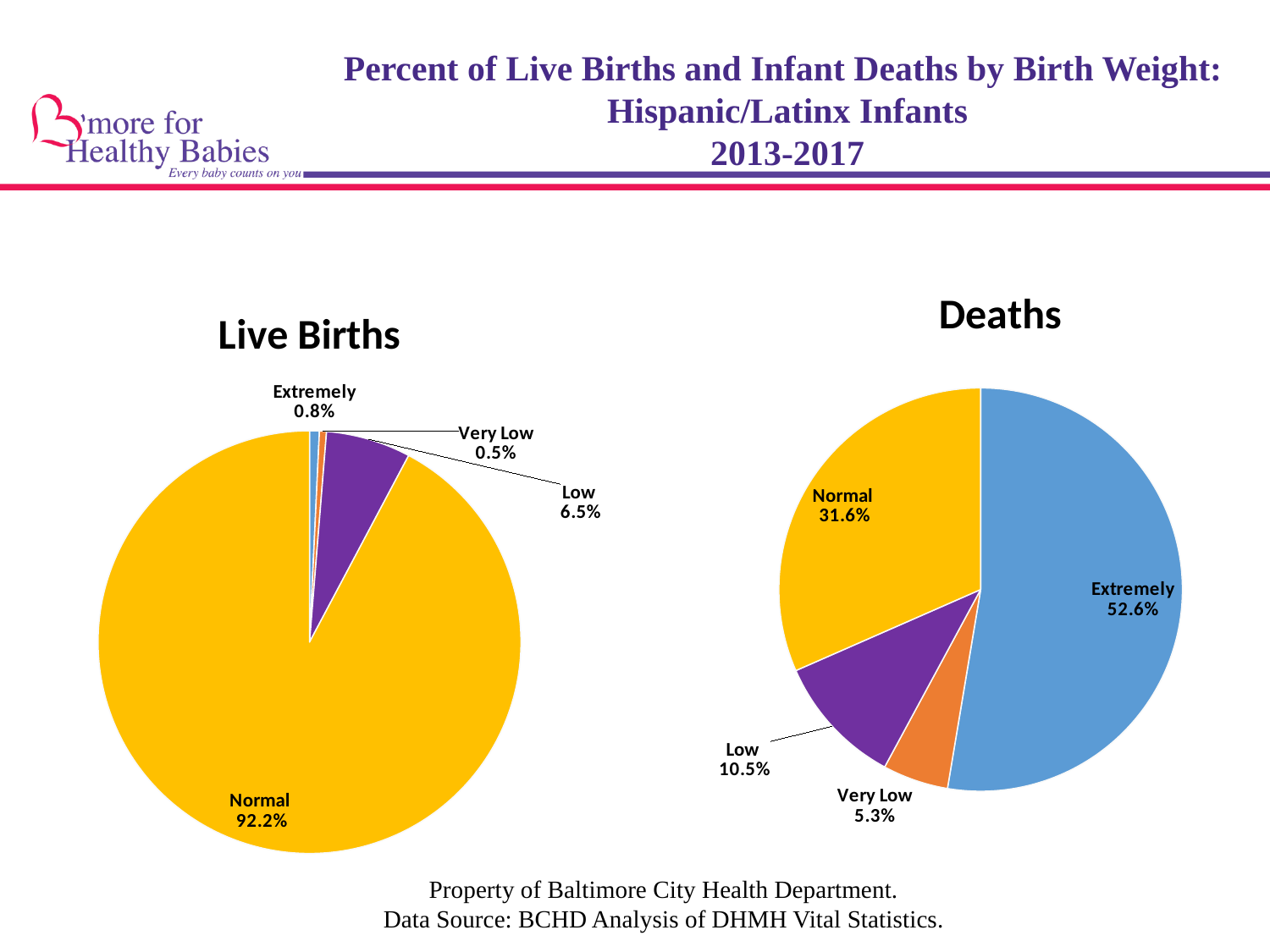
In the Deaths chart, what is the difference between the Extremely and Normal shares? 21.0% In the Deaths chart, what percentage of infant deaths were Extremely low birth weight? 52.6% How many birth weight categories are shown in the Deaths chart? 4 In the Deaths chart, which category has the smallest share? Very Low In the Deaths chart, what is the value for Very Low birth weight? 5.3% In the Deaths chart, which birth weight category has the largest share? Extremely In the Live Births chart, which birth weight category has the smallest share? Very Low In the Live Births chart, what is the difference between the Low and Extremely shares? 5.7% In the Deaths chart, which is larger: the Low share or the Very Low share? Low In the Live Births chart, what percentage of live births were Normal birth weight? 92.2% What type of chart is the Live Births chart? Pie chart In the Live Births chart, what is the value for Low birth weight? 6.5%